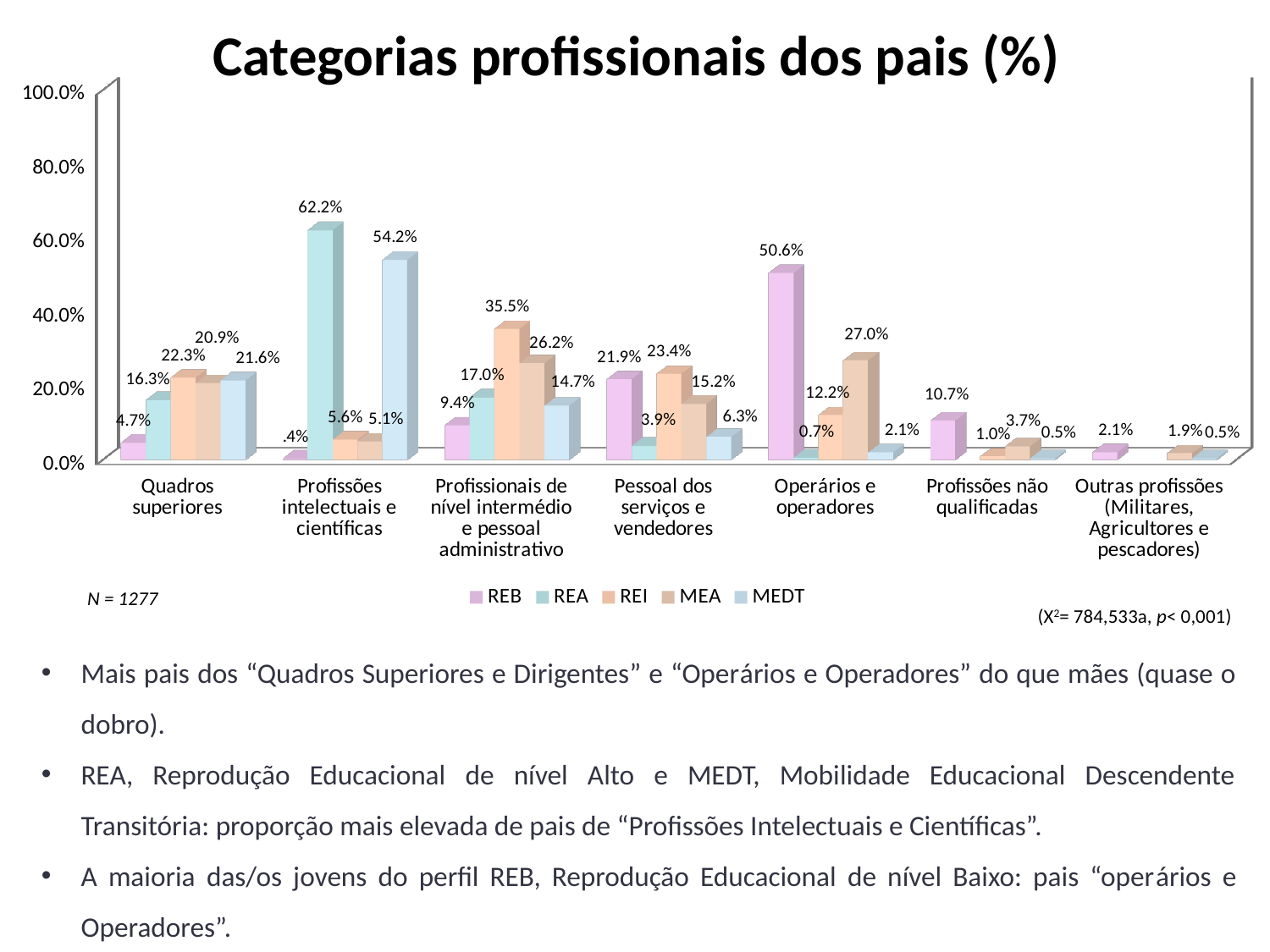
What is the value for REA in the "Profissões intelectuais e científicas" category? 62.2% What is the value for REB in the "Operários e operadores" category? 50.6% What is the value for REI in the "Profissionais de nível intermédio e pessoal administrativo" category? 35.5% How many professional categories are shown on the x axis? 7 What is the value for MEA in the "Operários e operadores" category? 27.0% What is the difference between the REA and MEDT values in the "Profissões intelectuais e científicas" category? 8.0 percentage points How many series does the legend list? 5 Which series has the lowest value in the "Profissões intelectuais e científicas" category? REB What kind of chart is shown on the slide? Bar chart In which category does the REB series reach its highest value? Operários e operadores In the "Pessoal dos serviços e vendedores" category, which is larger: the REB value or the REI value? REI What is the title of the chart? Categorias profissionais dos pais (%)